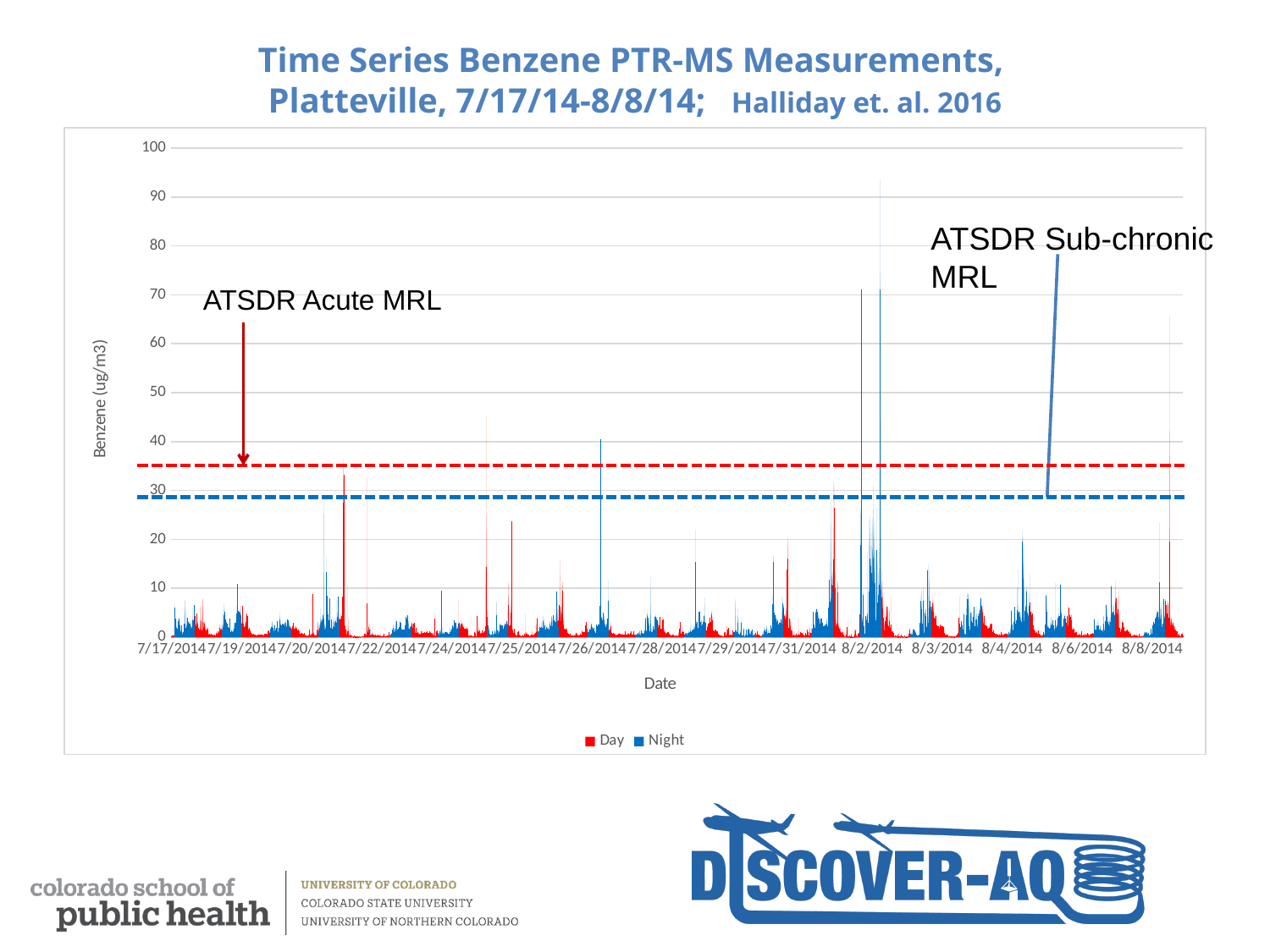
What is the label on the y axis? Benzene (ug/m3) What is the last date shown on the x axis? 8/8/2014 Is the ATSDR Acute MRL dashed line greater or less than 40? less How many series does the legend list? 2 What is the highest value shown on the y axis? 100 Is the ATSDR Sub-chronic MRL dashed line greater or less than 40? less How many date labels are shown along the x axis? 15 Is the highest benzene peak in the chart greater or less than 60? greater Which dashed reference line is higher on the chart, the ATSDR Acute MRL or the ATSDR Sub-chronic MRL? ATSDR Acute MRL What is the first date shown on the x axis? 7/17/2014 What are the two series named in the legend? Day and Night